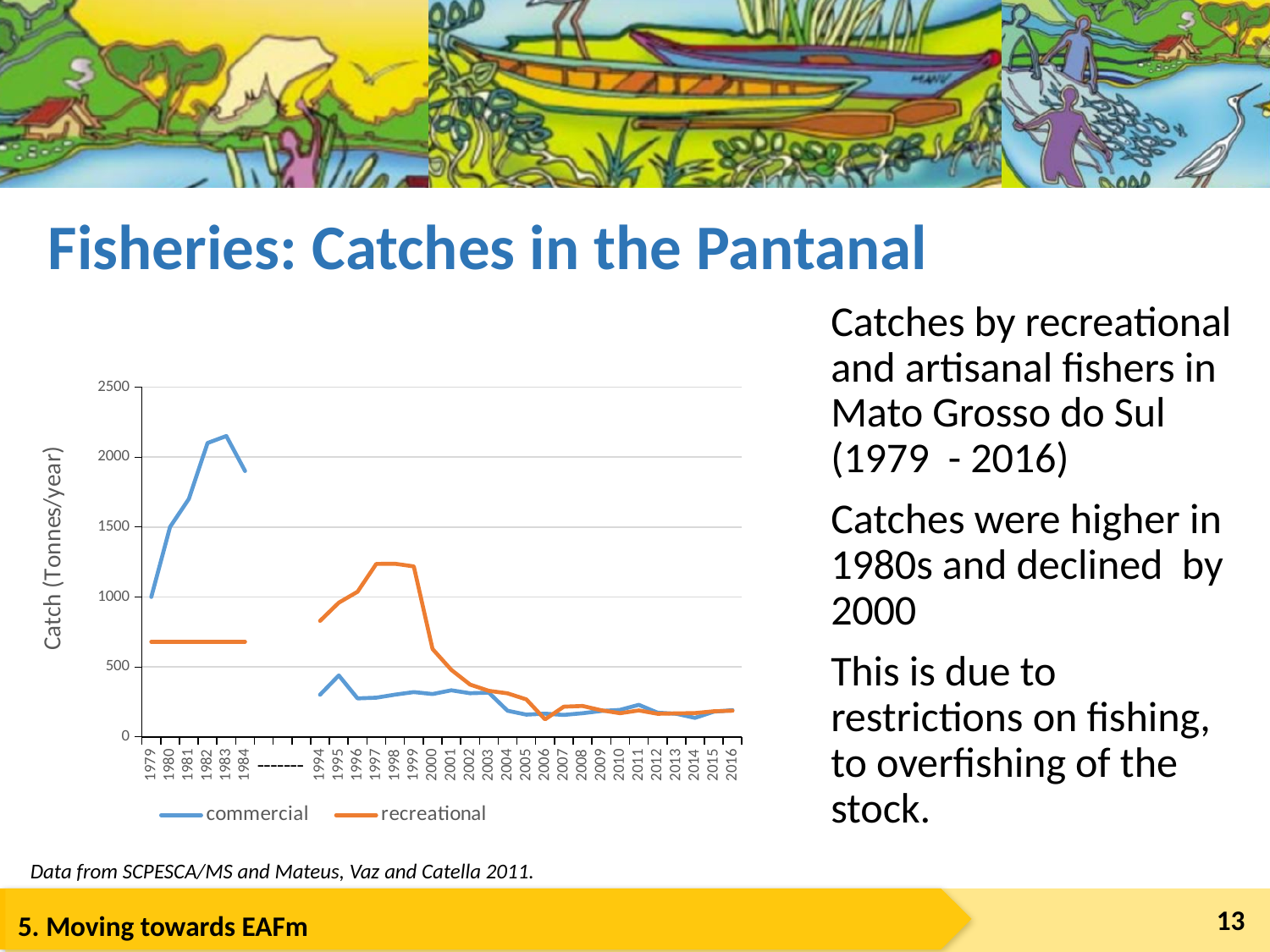
Is the recreational catch in 2016 greater or less than 500? less How many series does the legend list? 2 Is the commercial catch in 1983 greater or less than 2000? greater Does the commercial catch rise or fall from 1979 to 1983? rise Is the commercial catch in 1979 greater or less than 1500? less What kind of chart is shown on the slide? line chart What is the label on the vertical axis? Catch (Tonnes/year) What are the two series named in the legend? commercial and recreational In 1983, which series has the larger catch, commercial or recreational? commercial In 1998, which series has the larger catch, commercial or recreational? recreational